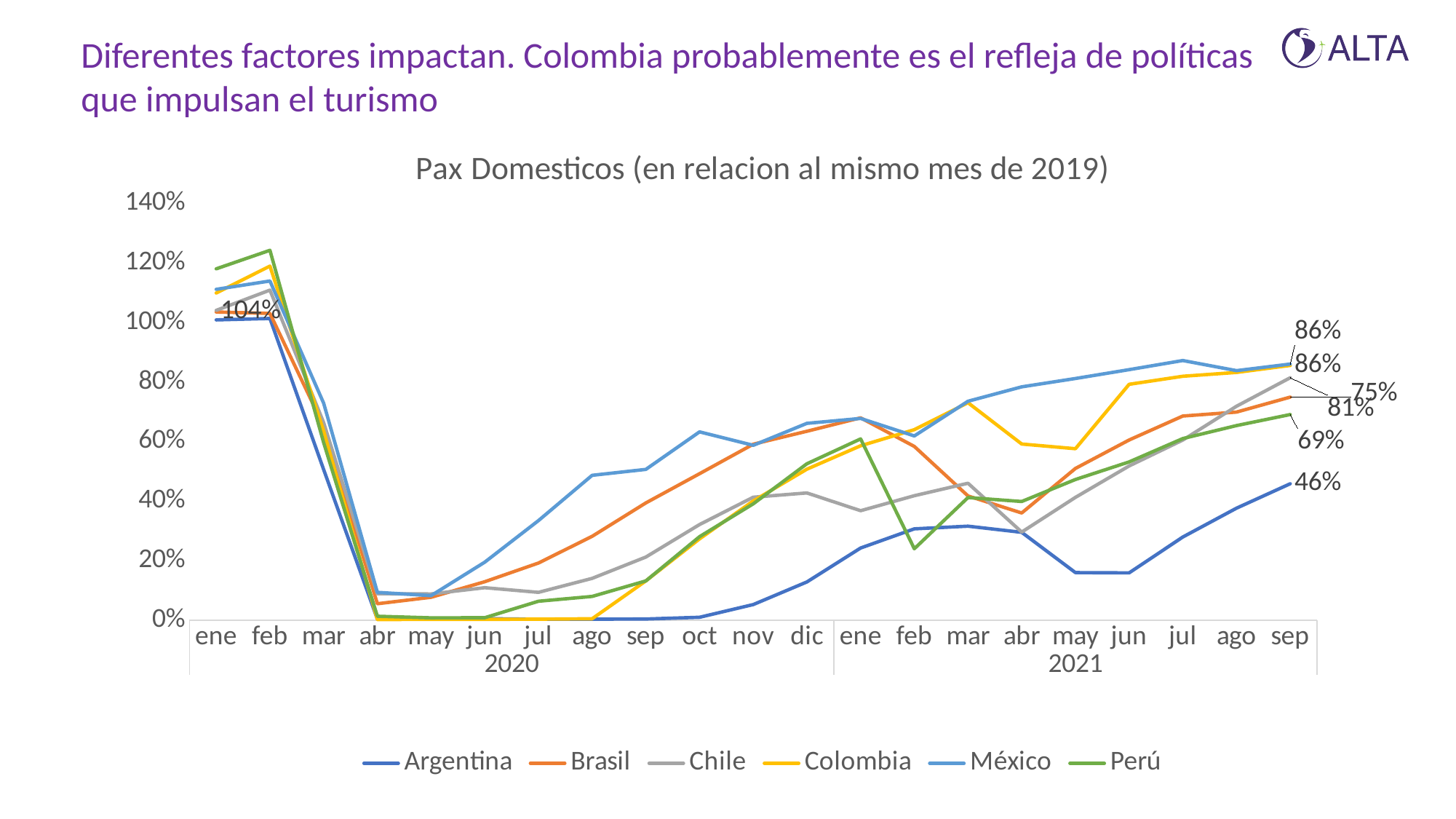
What is the value for Brasil in sep 2021? 75% What is the value for Chile in sep 2021? 81% What is the difference between the values for Chile and Argentina in sep 2021? 35 percentage points Is the value for Argentina in may 2021 greater or less than 20%? less Is the value for México in jul 2021 greater or less than 80%? greater How many series does the legend list? 6 What is the value for Perú in sep 2021? 69% In sep 2021, which is larger: the value for Brasil or the value for Perú? Brasil Which country has the lowest value in sep 2021? Argentina What is the value for Argentina in sep 2021? 46% What is the title of the chart? Pax Domesticos (en relacion al mismo mes de 2019) What kind of chart is shown on the slide? line chart